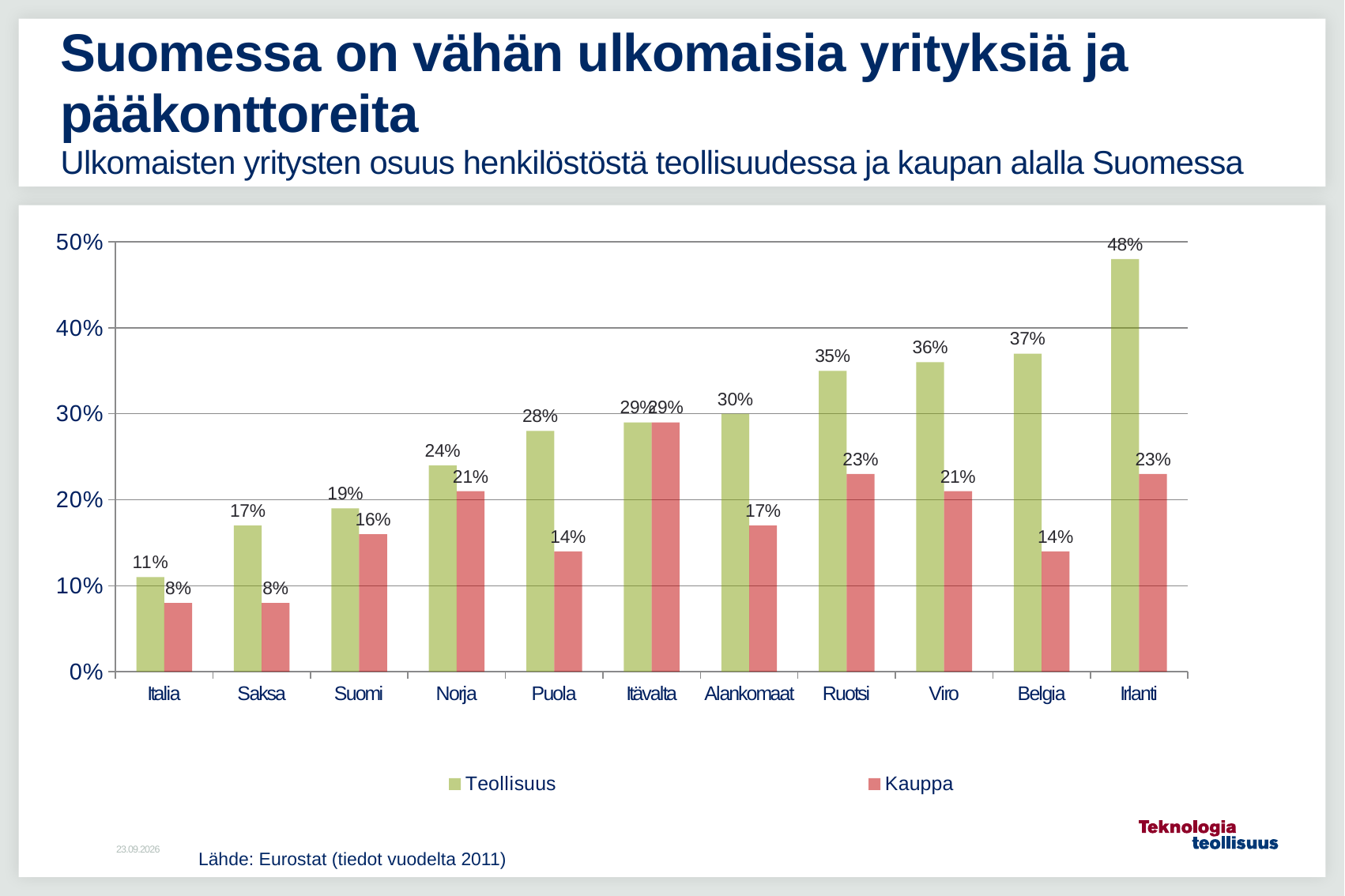
Is the Teollisuus value for Viro greater or less than 30%? greater Which is larger for Puola: the Teollisuus value or the Kauppa value? Teollisuus What is the Kauppa value for Ruotsi? 23% Do the Teollisuus values rise or fall from Italia to Irlanti along the x axis? Rise What is the Teollisuus value for Suomi? 19% What is the difference between the Teollisuus and Kauppa values for Belgia? 23% How many series does the legend list? 2 Which country has the lowest Teollisuus value? Italia Which colour represents the Kauppa series in the legend? Red Which country has the highest Teollisuus value? Irlanti How many countries are shown on the x axis? 11 What kind of chart is shown on the slide? Bar chart